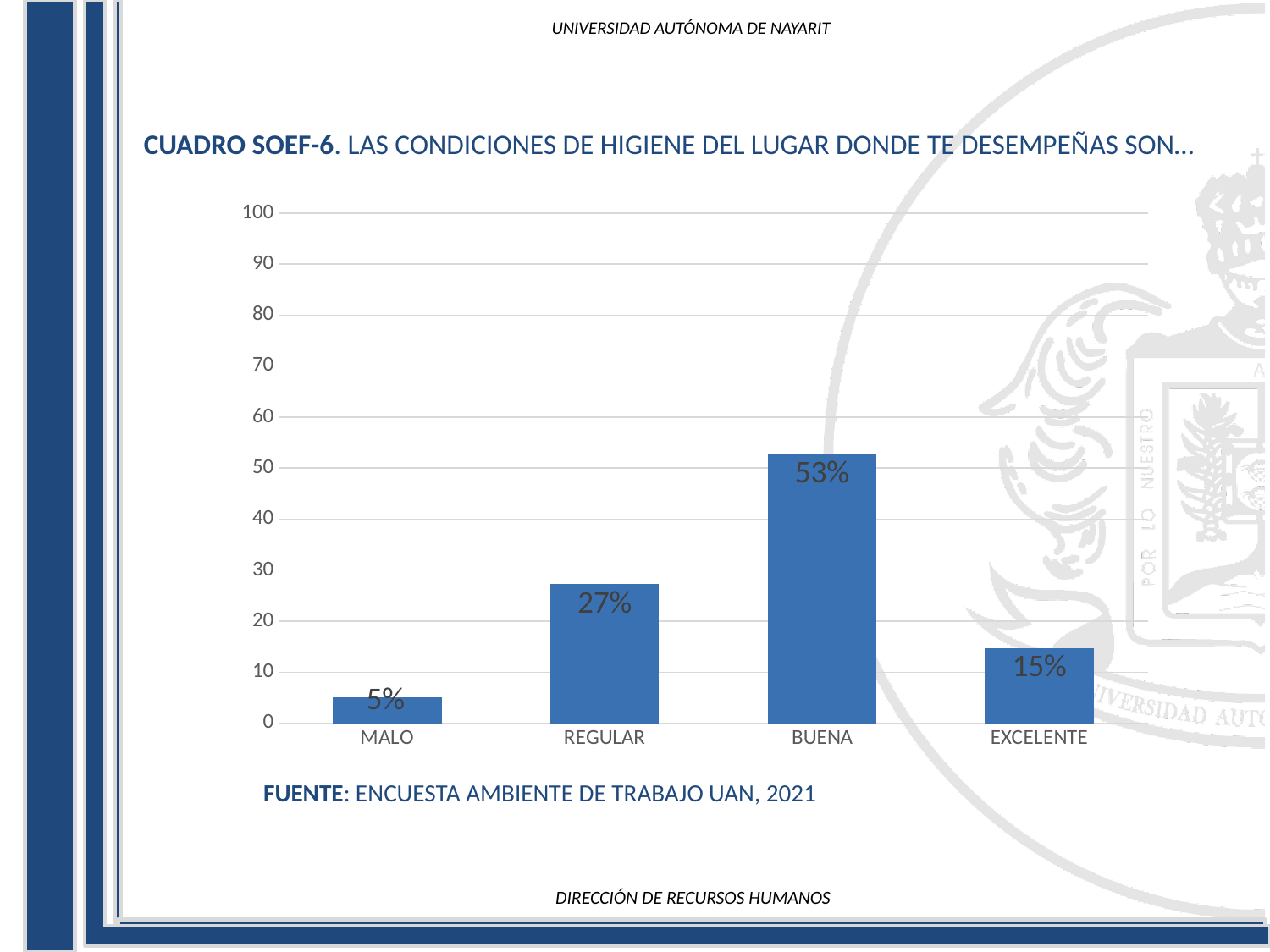
Is the value for BUENA greater or less than 50? greater What is the value for BUENA? 53% What is the value for EXCELENTE? 15% How many categories are shown on the x axis? 4 What is the value for REGULAR? 27% What source is cited below the chart? ENCUESTA AMBIENTE DE TRABAJO UAN, 2021 Which is larger, the value for REGULAR or the value for EXCELENTE? REGULAR What is the value for MALO? 5% Which category has the lowest value? MALO What kind of chart is shown on the slide? bar chart What is the difference between the values for BUENA and REGULAR? 26% Which category has the highest value? BUENA